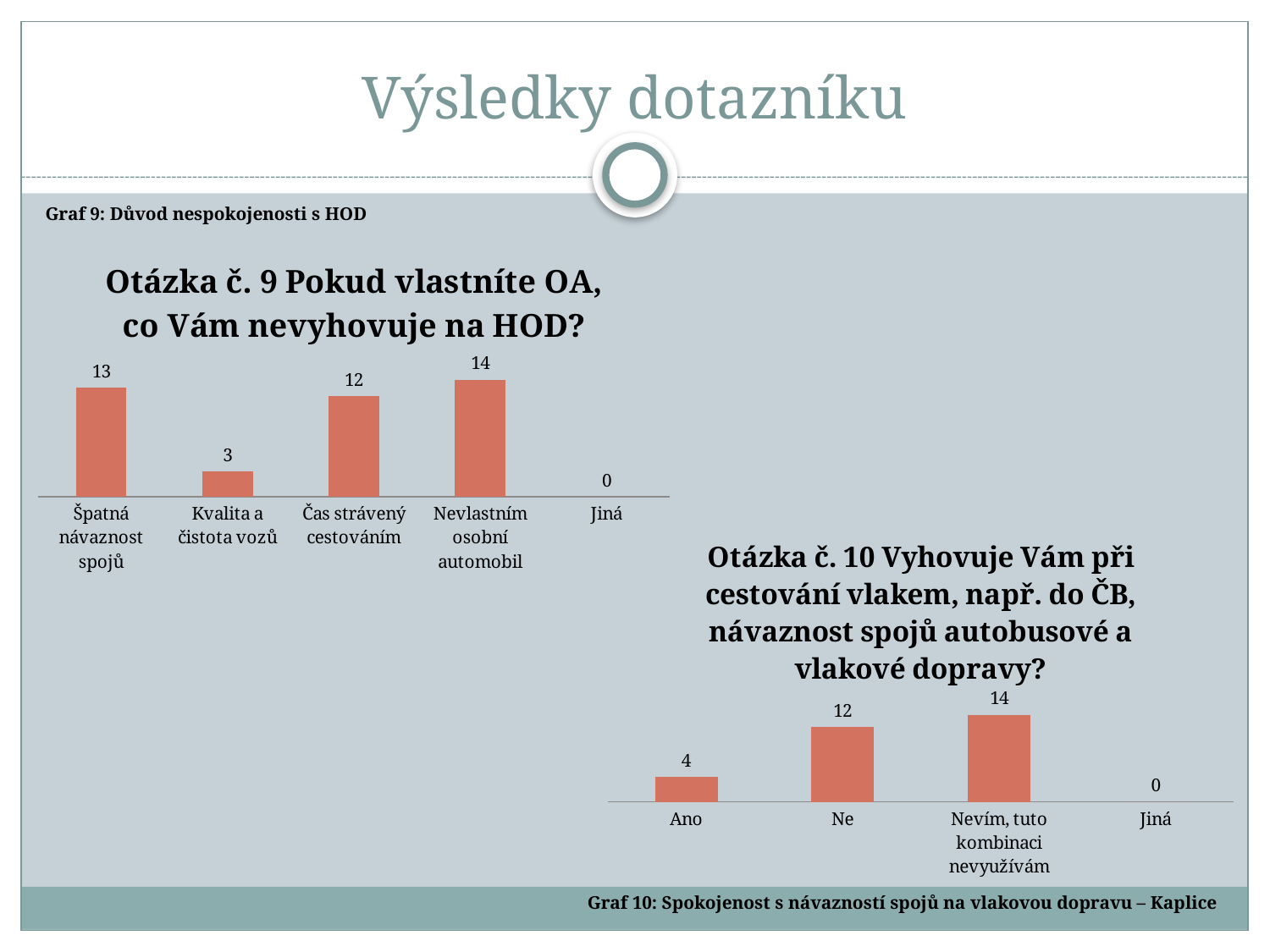
What kind of chart is the one titled 'Otázka č. 10 Vyhovuje Vám při cestování vlakem, např. do ČB, návaznost spojů autobusové a vlakové dopravy?'? Bar chart In the chart titled 'Otázka č. 9 Pokud vlastníte OA, co Vám nevyhovuje na HOD?', which category has the lowest value? Jiná In the chart titled 'Otázka č. 9 Pokud vlastníte OA, co Vám nevyhovuje na HOD?', what is the value for 'Špatná návaznost spojů'? 13 In the chart titled 'Otázka č. 9 Pokud vlastníte OA, co Vám nevyhovuje na HOD?', what is the value for 'Kvalita a čistota vozů'? 3 In the chart titled 'Otázka č. 10 Vyhovuje Vám při cestování vlakem, např. do ČB, návaznost spojů autobusové a vlakové dopravy?', how many categories are shown? 4 In the chart titled 'Otázka č. 10 Vyhovuje Vám při cestování vlakem, např. do ČB, návaznost spojů autobusové a vlakové dopravy?', what is the value for 'Ano'? 4 In the chart titled 'Otázka č. 10 Vyhovuje Vám při cestování vlakem, např. do ČB, návaznost spojů autobusové a vlakové dopravy?', what is the value for 'Nevím, tuto kombinaci nevyužívám'? 14 In the chart titled 'Otázka č. 9 Pokud vlastníte OA, co Vám nevyhovuje na HOD?', what is the difference between 'Nevlastním osobní automobil' and 'Čas strávený cestováním'? 2 In the chart titled 'Otázka č. 9 Pokud vlastníte OA, co Vám nevyhovuje na HOD?', which category has the highest value? Nevlastním osobní automobil In the chart titled 'Otázka č. 9 Pokud vlastníte OA, co Vám nevyhovuje na HOD?', how many categories are shown? 5 In the chart titled 'Otázka č. 10 Vyhovuje Vám při cestování vlakem, např. do ČB, návaznost spojů autobusové a vlakové dopravy?', what is the difference between 'Ne' and 'Ano'? 8 In the chart titled 'Otázka č. 10 Vyhovuje Vám při cestování vlakem, např. do ČB, návaznost spojů autobusové a vlakové dopravy?', which is larger, 'Ano' or 'Ne'? Ne